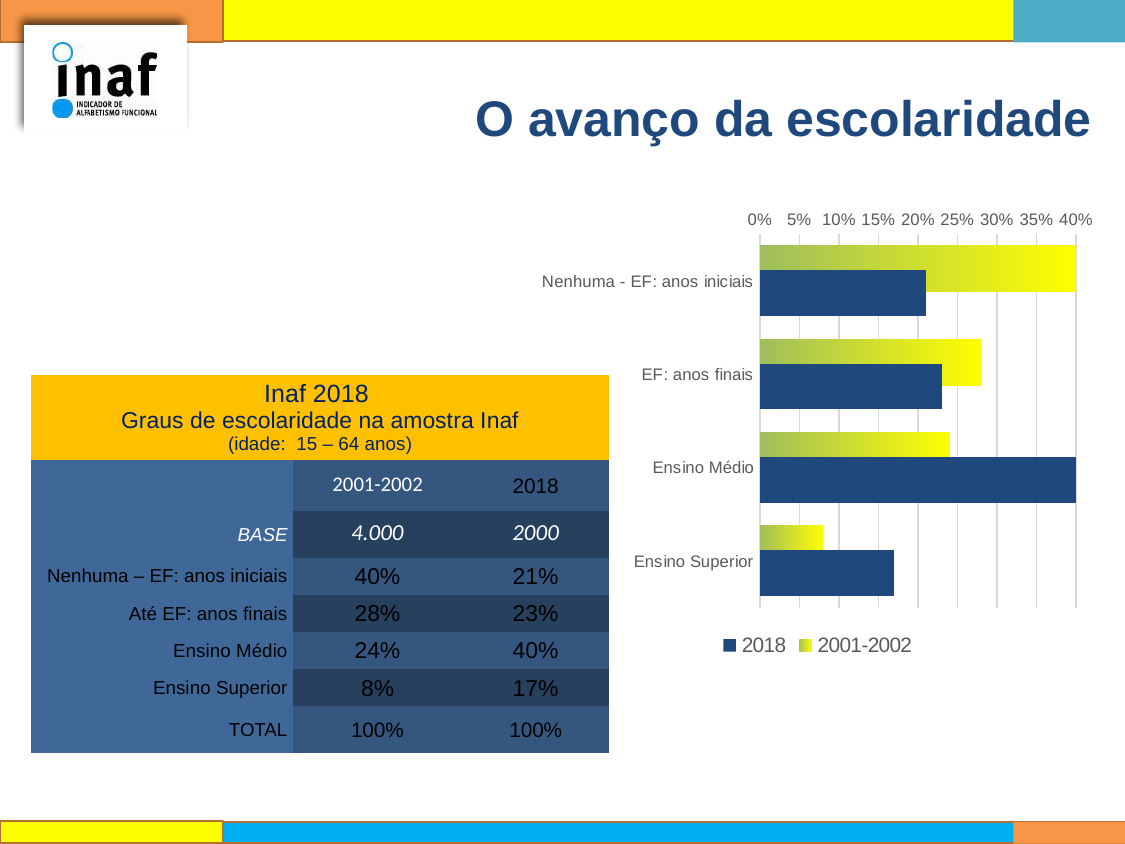
Which series is shown in dark blue in the chart's legend? 2018 Which category has the lowest value for the 2001-2002 series? Ensino Superior For Ensino Superior, which series has the larger value, 2018 or 2001-2002? 2018 What type of chart is shown on the right of the slide? bar chart In the chart, what is the 2018 value for Ensino Médio? 40% Is the 2018 value for Ensino Superior greater or less than 20%? less For Ensino Médio, which series has the larger value, 2018 or 2001-2002? 2018 In the chart, what is the 2001-2002 value for Nenhuma - EF: anos iniciais? 40% Which category has the highest value for the 2018 series? Ensino Médio How many education-level categories are plotted in the chart? 4 How many series does the chart's legend list? 2 Is the 2001-2002 value for Ensino Superior greater or less than 10%? less